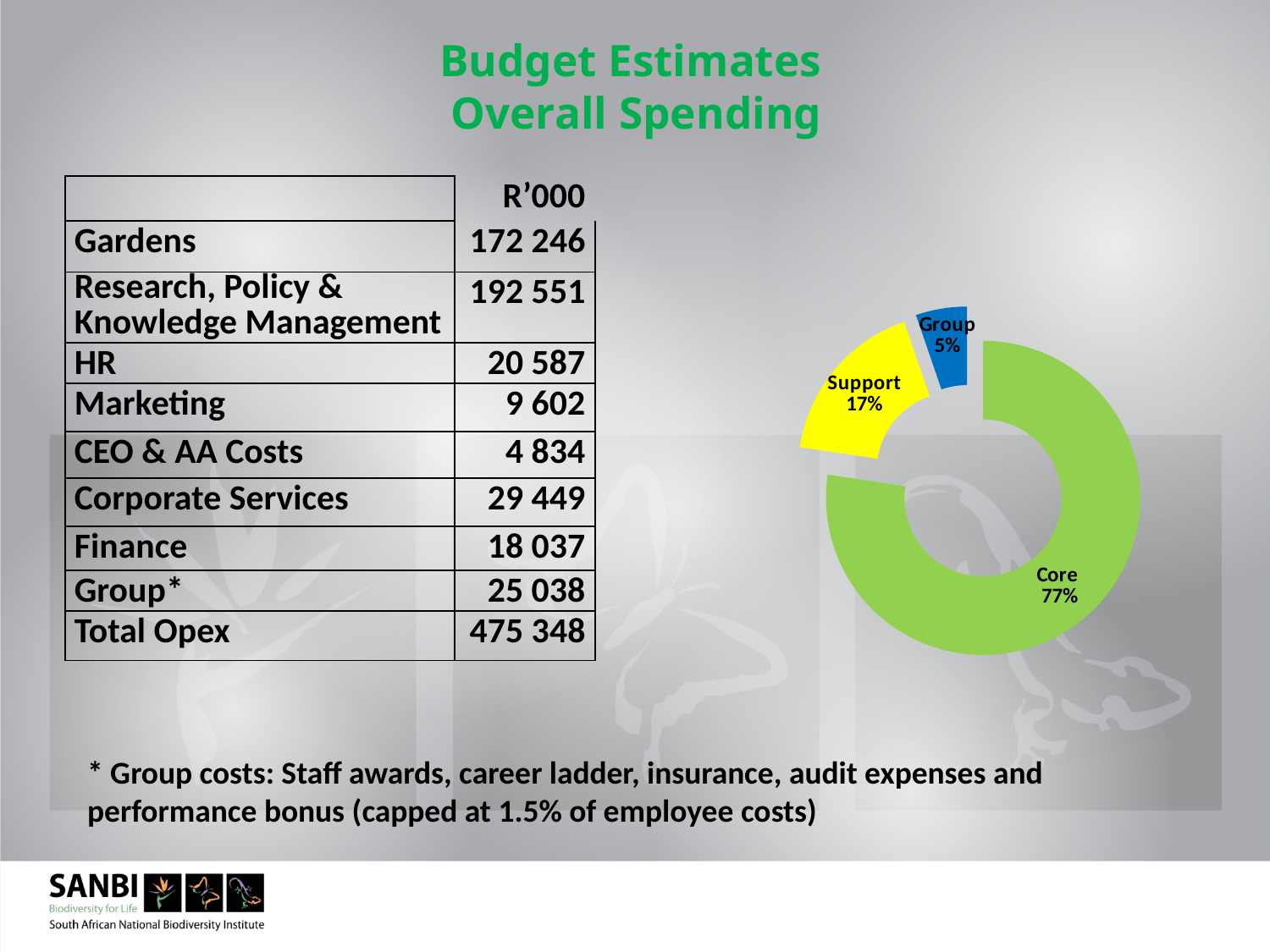
What share of the doughnut chart does Support represent? 17% Which slice of the doughnut chart is the smallest? Group What colour is the Support slice in the doughnut chart? Yellow What is the difference in percentage points between the Core and Support slices? 60 What colour is the Group slice in the doughnut chart? Blue What is the difference in percentage points between the Support and Group slices? 12 What share of the doughnut chart does Core represent? 77% What kind of chart is shown on the slide? Doughnut chart How many slices does the doughnut chart have? 3 Which slice is larger, Support or Group? Support Which slice of the doughnut chart is the largest? Core What share of the doughnut chart does Group represent? 5%